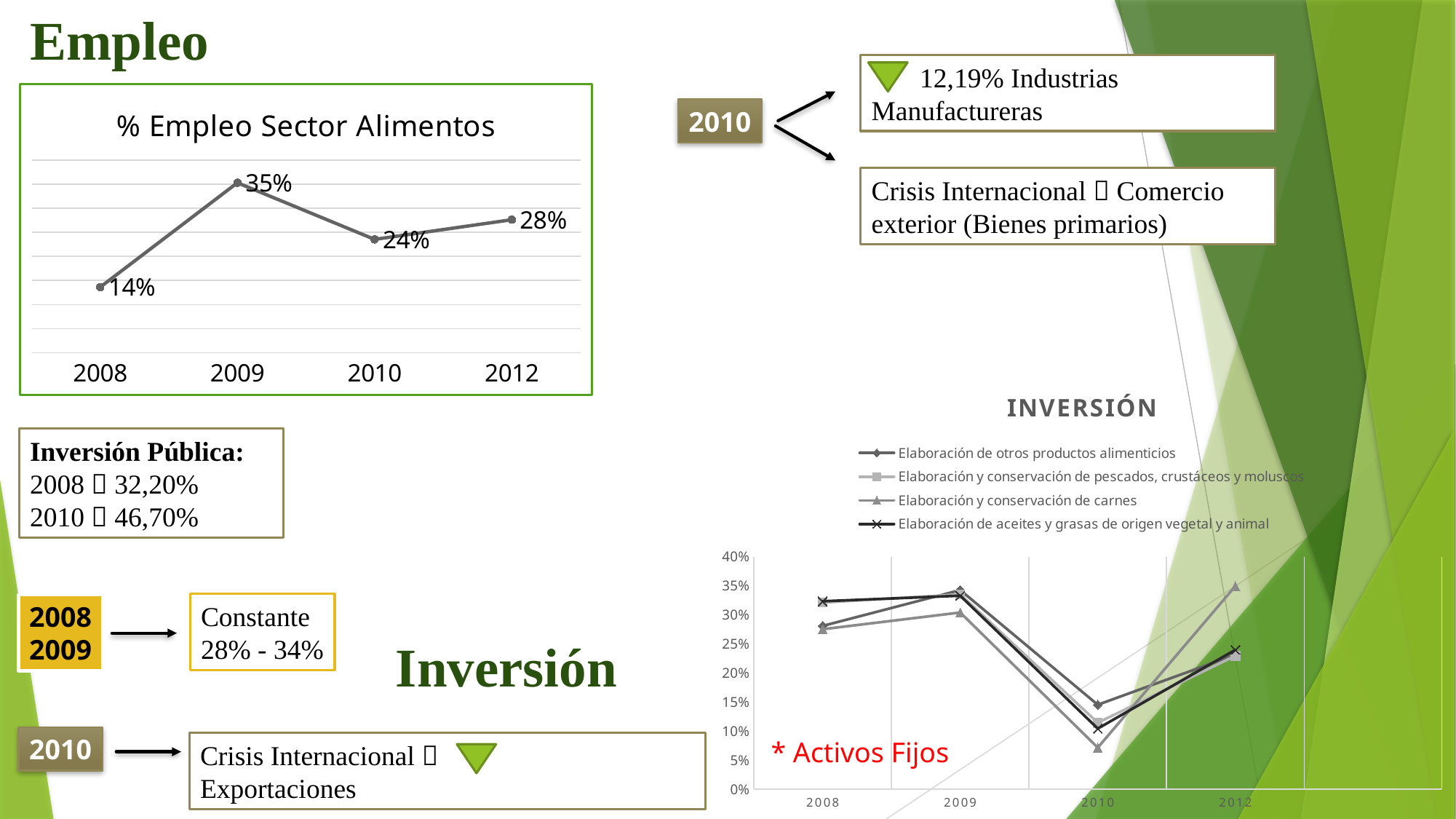
In the '% Empleo Sector Alimentos' chart, which year has the highest value? 2009 In the '% Empleo Sector Alimentos' chart, what is the difference between the 2009 and 2010 values? 11% In the 'INVERSIÓN' chart, is the 2010 value for 'Elaboración y conservación de carnes' greater or less than 10%? less In the '% Empleo Sector Alimentos' chart, what is the value for 2008? 14% In the 'INVERSIÓN' chart, is the 2012 value for 'Elaboración y conservación de carnes' greater or less than 30%? greater In the '% Empleo Sector Alimentos' chart, what is the value for 2009? 35% How many data points are plotted in the '% Empleo Sector Alimentos' chart? 4 How many series does the legend of the 'INVERSIÓN' chart list? 4 In the 'INVERSIÓN' chart, which series has the highest value in 2012? Elaboración y conservación de carnes In the '% Empleo Sector Alimentos' chart, which year has the lowest value? 2008 What kind of chart is the '% Empleo Sector Alimentos' chart? Line chart In the '% Empleo Sector Alimentos' chart, which is larger, the value for 2010 or the value for 2012? 2012